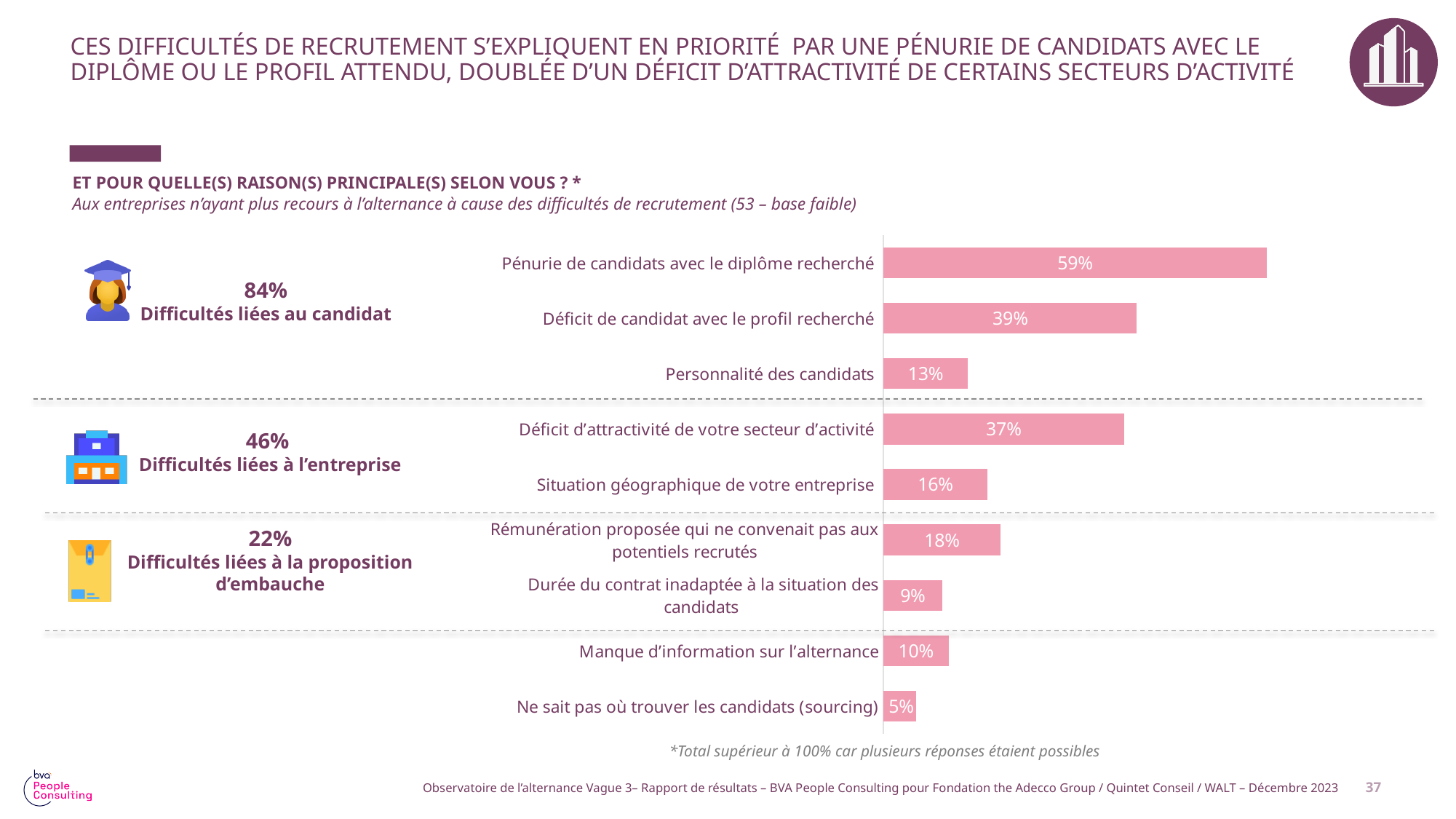
What percentage is shown next to "Difficultés liées à l'entreprise" on the left of the chart? 46% What is the value for "Durée du contrat inadaptée à la situation des candidats"? 9% What percentage is shown for "Situation géographique de votre entreprise"? 16% What percentage is shown for "Pénurie de candidats avec le diplôme recherché"? 59% How many bars are plotted in the chart? 9 Which is larger: "Déficit de candidat avec le profil recherché" or "Déficit d'attractivité de votre secteur d'activité"? Déficit de candidat avec le profil recherché Which category has the lowest value in the chart? Ne sait pas où trouver les candidats (sourcing) Which category has the highest value in the chart? Pénurie de candidats avec le diplôme recherché What is the difference between "Rémunération proposée qui ne convenait pas aux potentiels recrutés" and "Manque d'information sur l'alternance"? 8 percentage points What type of chart is shown on the slide? Bar chart What is the value for "Déficit d'attractivité de votre secteur d'activité"? 37% What is the difference between "Pénurie de candidats avec le diplôme recherché" and "Déficit de candidat avec le profil recherché"? 20 percentage points